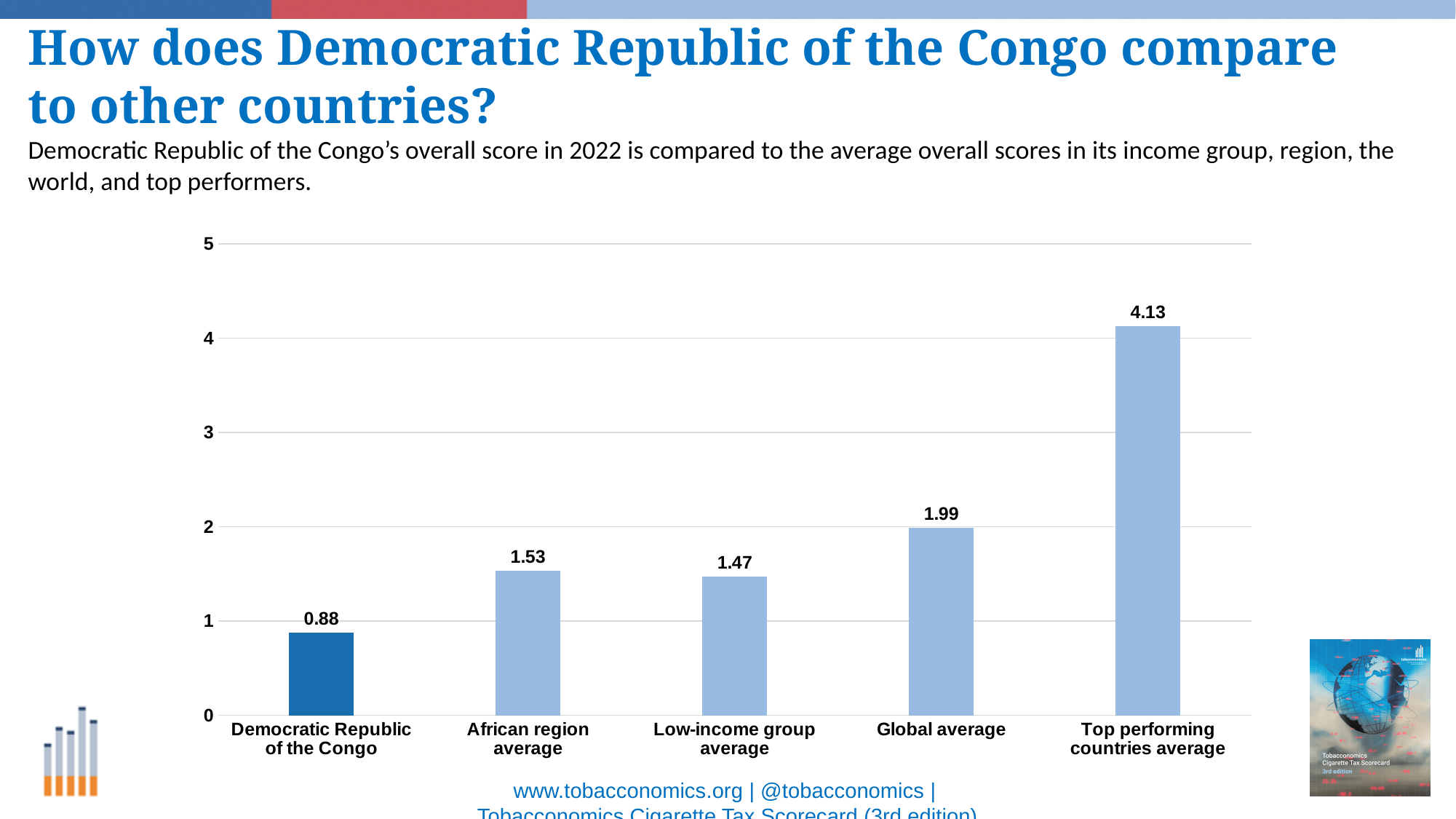
Which category has the highest value? Top performing countries average What is the value for the Low-income group average? 1.47 What is the difference between the Global average and the African region average? 0.46 Which category has the lowest value? Democratic Republic of the Congo What is the overall score for Democratic Republic of the Congo? 0.88 What is the difference between the Top performing countries average and the Democratic Republic of the Congo score? 3.25 What kind of chart is shown on the slide? Bar chart What is the value for the Top performing countries average? 4.13 How many categories are shown on the chart? 5 What is the value for the Global average? 1.99 What is the value for the African region average? 1.53 Which is larger, the African region average or the Low-income group average? African region average